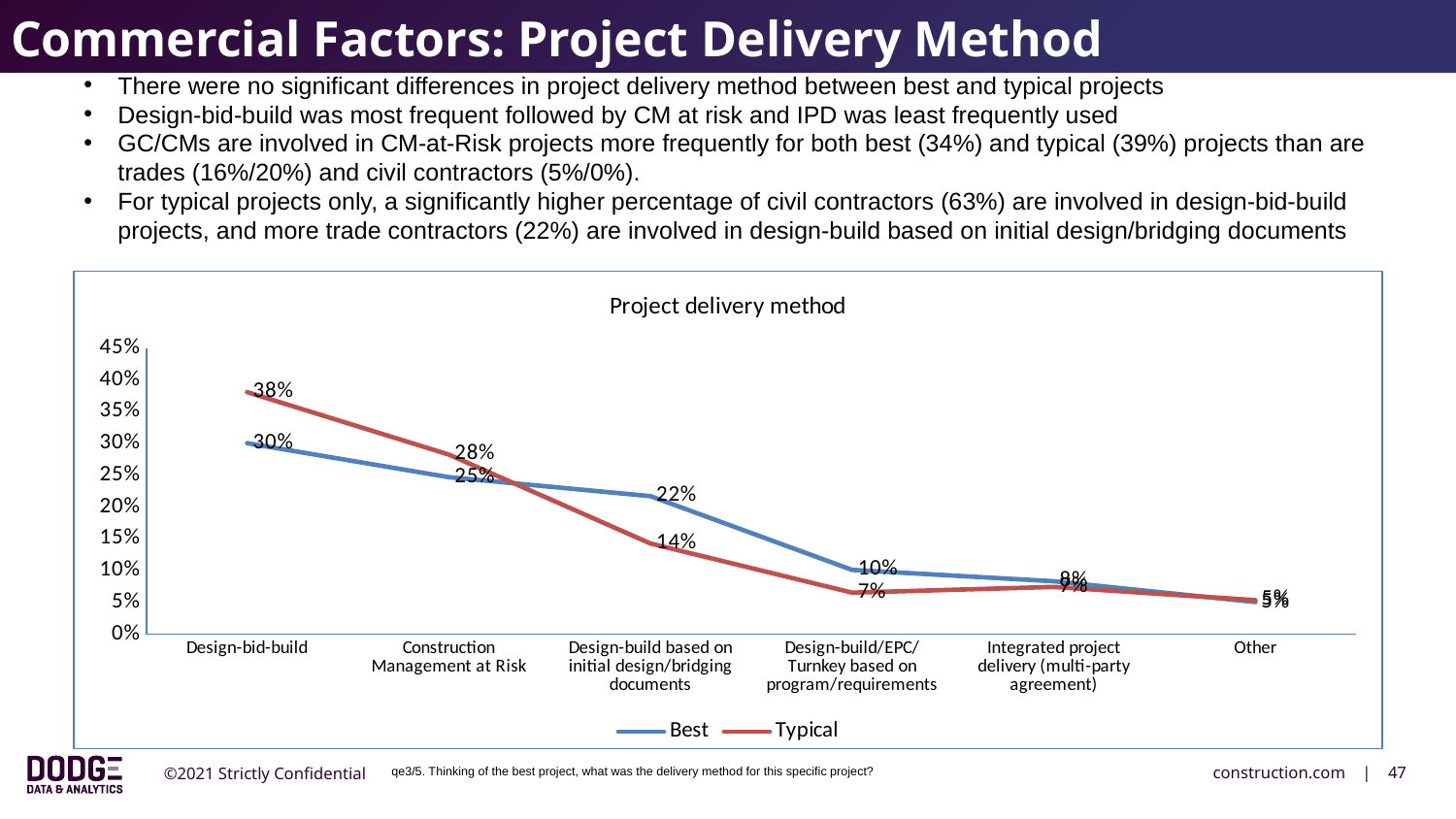
How many series does the chart legend list? 2 What is the Typical value for Construction Management at Risk? 28% What is the title of the chart? Project delivery method What is the Typical value for Design-bid-build? 38% What is the difference between the Typical and Best values for Design-bid-build? 8% Do the Best values generally rise or fall moving from Design-bid-build to Other along the x axis? fall What is the Best value for Design-build based on initial design/bridging documents? 22% What is the Best value for Design-bid-build? 30% For Design-build based on initial design/bridging documents, which series has the larger value, Best or Typical? Best How many delivery method categories are shown on the x axis? 6 What type of chart is shown on the slide? line chart Which category has the highest Typical value? Design-bid-build